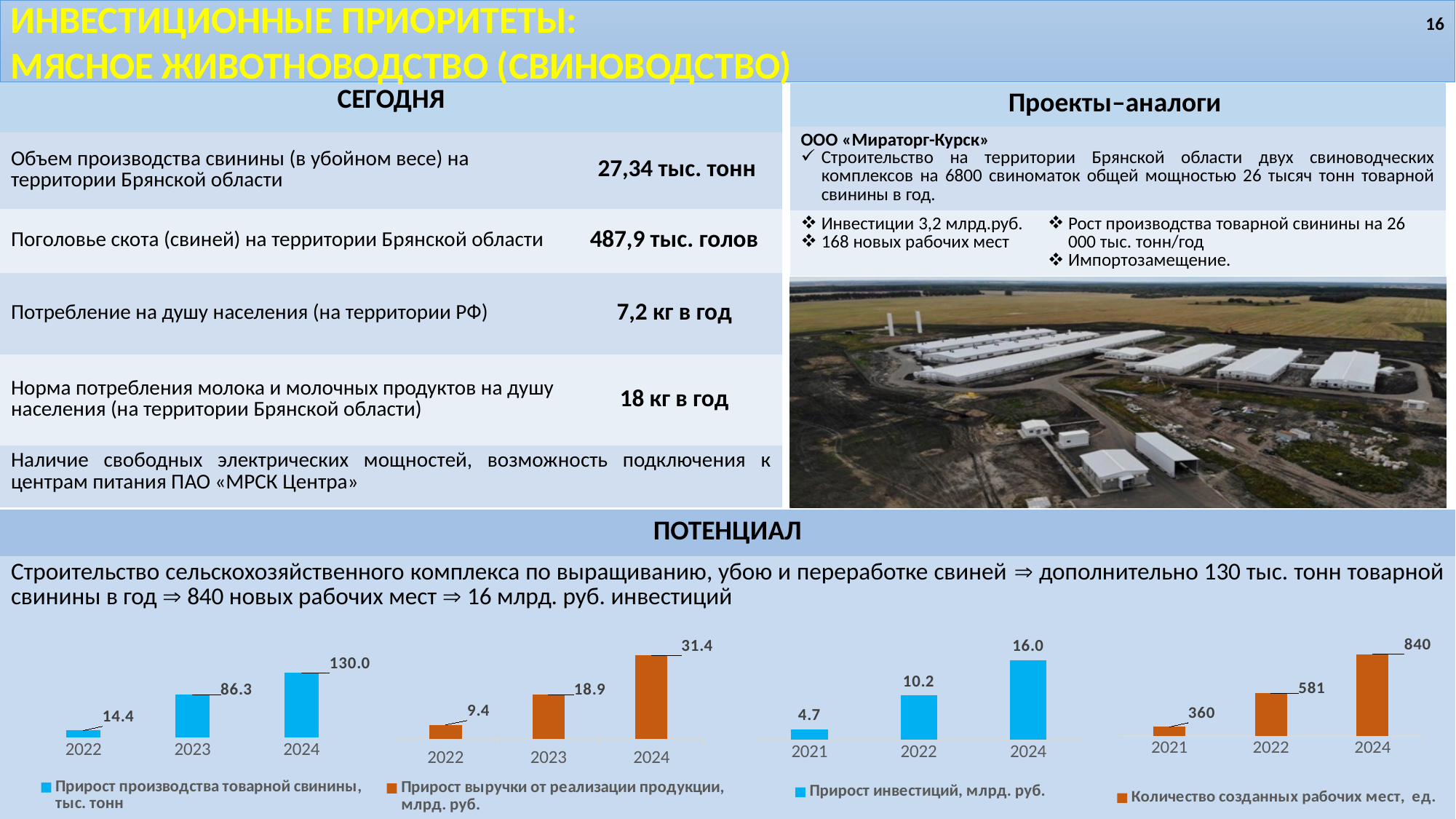
In the chart 'Прирост производства товарной свинины, тыс. тонн', which year has the highest value? 2024 In the chart 'Прирост выручки от реализации продукции, млрд. руб.', what is the difference between the 2024 and 2023 values? 12.5 In the chart 'Прирост выручки от реализации продукции, млрд. руб.', do the values rise or fall from 2022 to 2024? Rise In the chart 'Прирост выручки от реализации продукции, млрд. руб.', what is the value for 2022? 9.4 In the chart 'Прирост инвестиций, млрд. руб.', what is the value for 2021? 4.7 In the chart 'Прирост производства товарной свинины, тыс. тонн', what is the value for 2023? 86.3 In the chart 'Количество созданных рабочих мест, ед.', which is larger, the value for 2021 or 2024? 2024 How many bars are in the chart 'Количество созданных рабочих мест, ед.'? 3 In the chart 'Прирост инвестиций, млрд. руб.', which year has the lowest value? 2021 What type of chart is 'Прирост инвестиций, млрд. руб.'? Bar chart In the chart 'Прирост производства товарной свинины, тыс. тонн', what is the difference between the 2024 and 2022 values? 115.6 In the chart 'Количество созданных рабочих мест, ед.', what is the value for 2022? 581